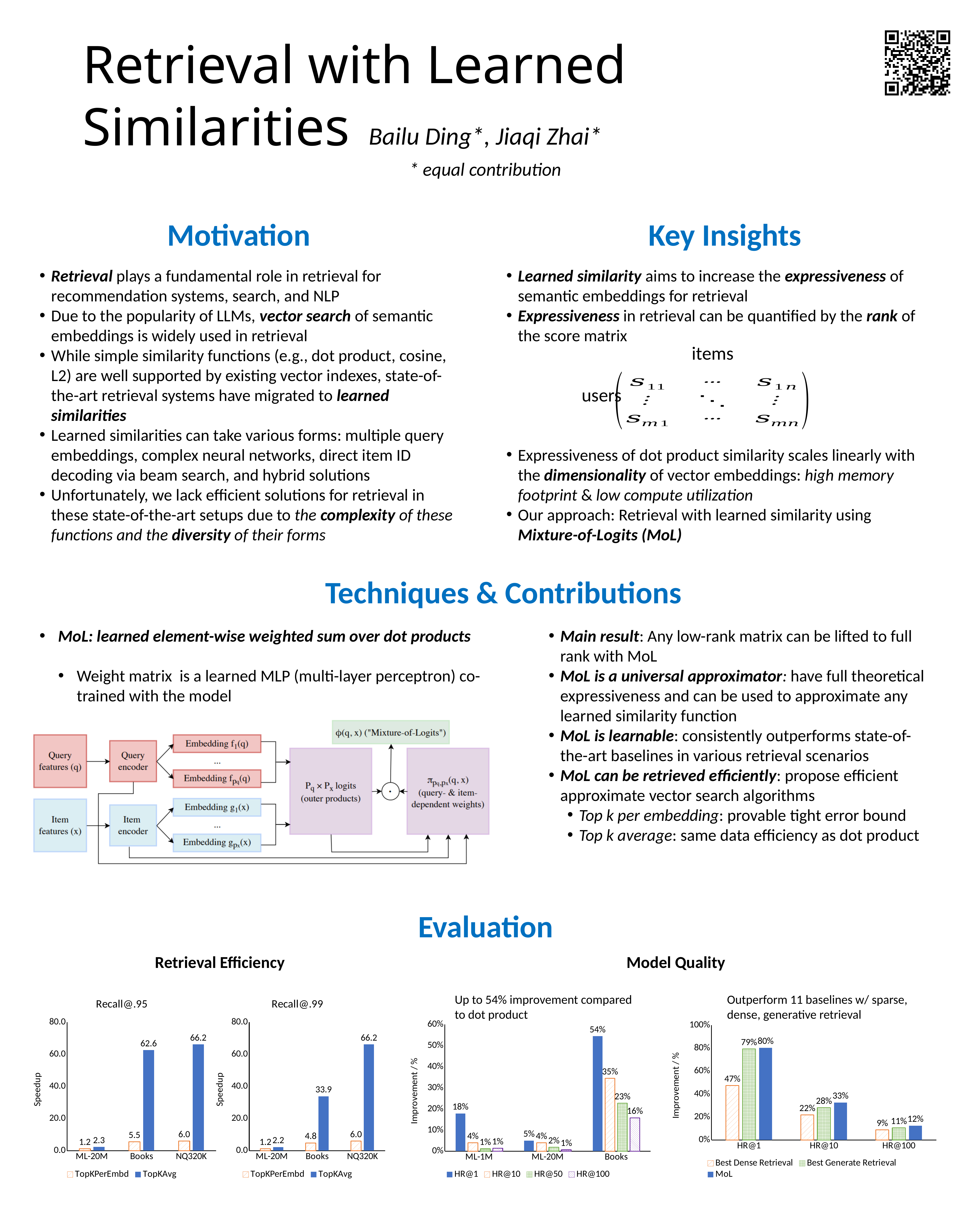
In the chart titled 'Up to 54% improvement compared to dot product', what is the HR@1 improvement on Books? 54% In the Recall@.99 chart, what is the speedup of TopKAvg on Books? 33.9 In the chart titled 'Up to 54% improvement compared to dot product', what is the HR@10 improvement on ML-1M? 4% In the Recall@.95 chart, which dataset has the highest TopKAvg speedup? NQ320K In the chart titled 'Outperform 11 baselines w/ sparse, dense, generative retrieval', which is larger at HR@1: Best Dense Retrieval or Best Generate Retrieval? Best Generate Retrieval In the Recall@.99 chart, what is the difference between the TopKAvg and TopKPerEmbd speedups on NQ320K? 60.2 In the Recall@.95 chart, what is the speedup of TopKAvg on Books? 62.6 What kind of chart is the Recall@.99 chart? Bar chart How many series does the legend of the Recall@.95 chart list? 2 In the chart titled 'Outperform 11 baselines w/ sparse, dense, generative retrieval', what is the difference between MoL and Best Dense Retrieval at HR@10? 11% In the chart titled 'Up to 54% improvement compared to dot product', how many series does the legend list? 4 In the chart titled 'Outperform 11 baselines w/ sparse, dense, generative retrieval', what is the value for Best Dense Retrieval at HR@1? 47%